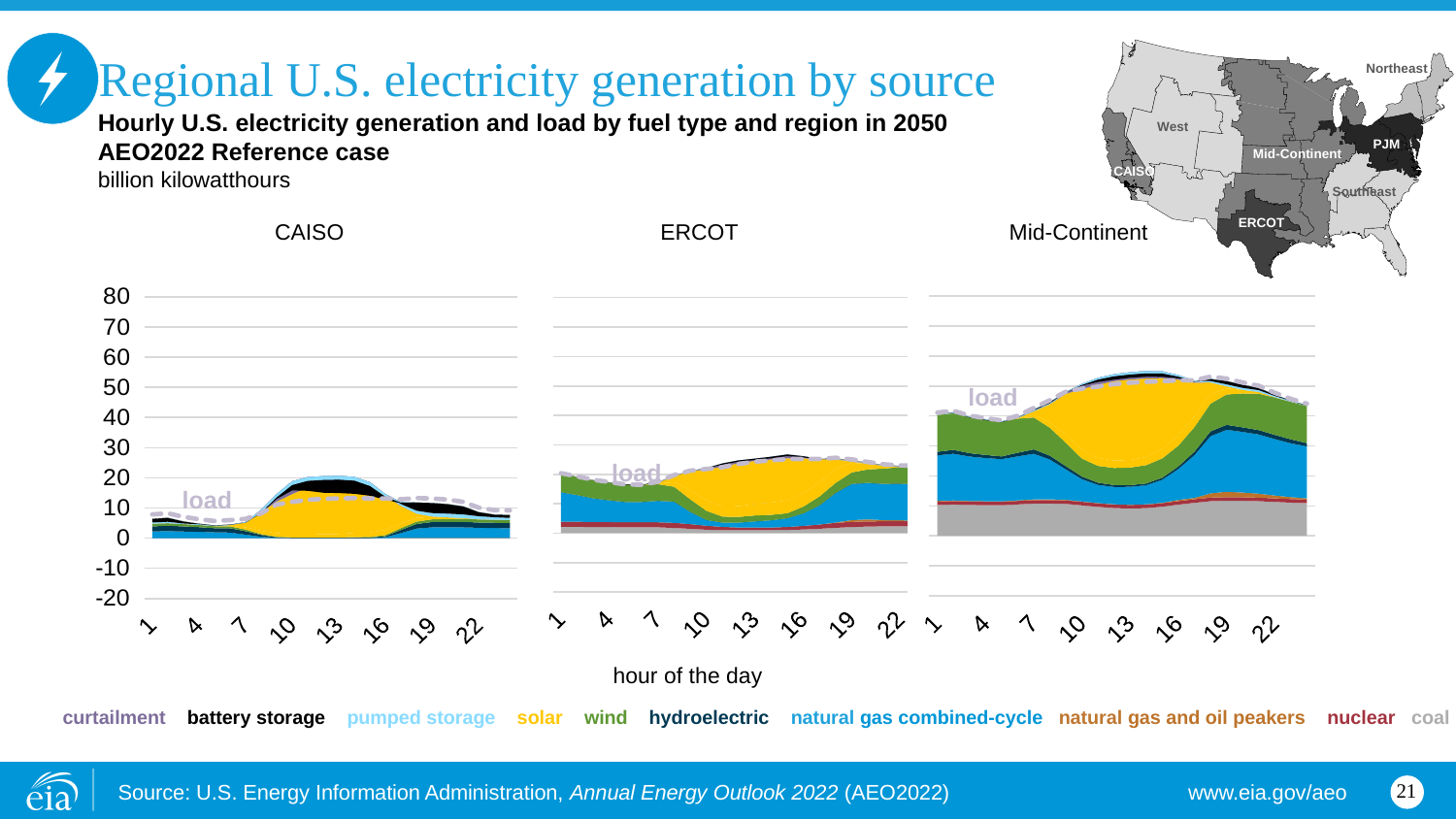
In the CAISO chart, is the peak total generation around hour 13 greater or less than 30? less What kind of chart is used for the CAISO, ERCOT and Mid-Continent panels? stacked area chart Which of the three regions has the highest peak hourly generation? Mid-Continent In the CAISO chart, does total generation rise or fall between hour 7 and hour 13? rise How many fuel-type series does the legend at the bottom of the slide list? 10 In the Mid-Continent chart, is the peak total generation around hour 13 greater or less than 50? greater Which of the three regions has the lowest peak hourly generation? CAISO How many regional charts are shown on the slide? 3 Is the peak generation in ERCOT larger or smaller than the peak generation in CAISO? larger In the Mid-Continent chart, is the total generation at hour 1 greater or less than 30? greater What unit is used on the y axis of the charts? billion kilowatthours